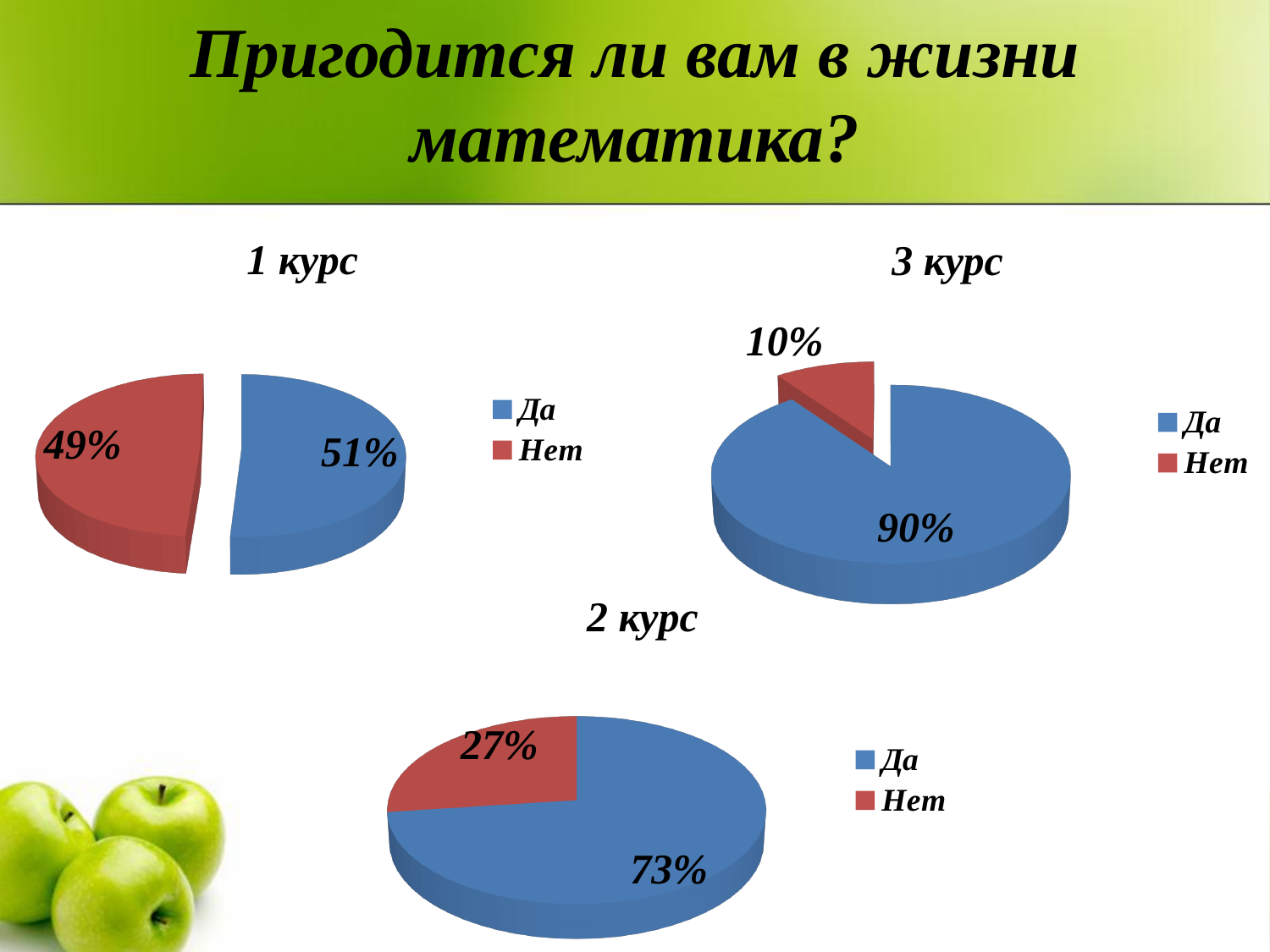
What type of chart is the "2 курс" chart? Pie chart In the "3 курс" chart, what share of respondents answered "Да"? 90% In the "1 курс" chart, what share of respondents answered "Да"? 51% How many series does the legend of the "1 курс" chart list? 2 In the "2 курс" chart, which answer has the larger share? Да In the "2 курс" chart, what share of respondents answered "Нет"? 27% In the "1 курс" chart, what share of respondents answered "Нет"? 49% In the "3 курс" chart, what is the difference between the "Да" and "Нет" shares? 80% How many pie charts are shown on the slide? 3 In the "2 курс" chart, what share of respondents answered "Да"? 73% In the "3 курс" chart, what share of respondents answered "Нет"? 10% In the "3 курс" chart, which answer has the smaller share? Нет